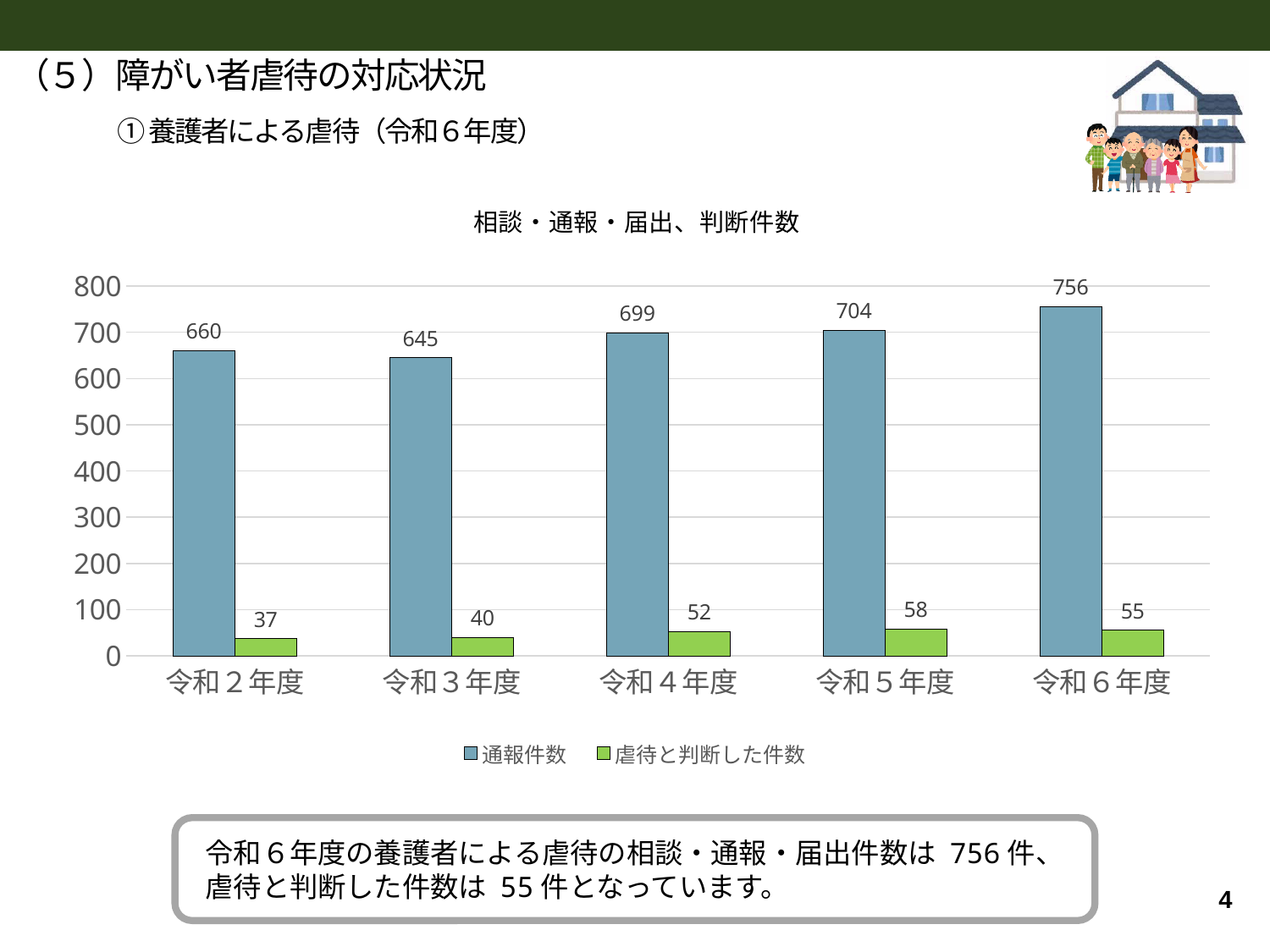
Which year has the highest 通報件数? 令和６年度 How many series does the legend list? 2 What is the 虐待と判断した件数 value for 令和３年度? 40 Is the 通報件数 for 令和４年度 greater or less than 600? greater What is the difference between the 通報件数 for 令和６年度 and 令和５年度? 52 What is the title of the chart? 相談・通報・届出、判断件数 How many fiscal years are shown on the x axis? 5 Which year has the lowest 虐待と判断した件数? 令和２年度 What is the 通報件数 value for 令和６年度? 756 What kind of chart is shown on the slide? bar chart Which is larger, the 通報件数 for 令和２年度 or for 令和３年度? 令和２年度 Does the 通報件数 rise or fall from 令和３年度 to 令和６年度? rise